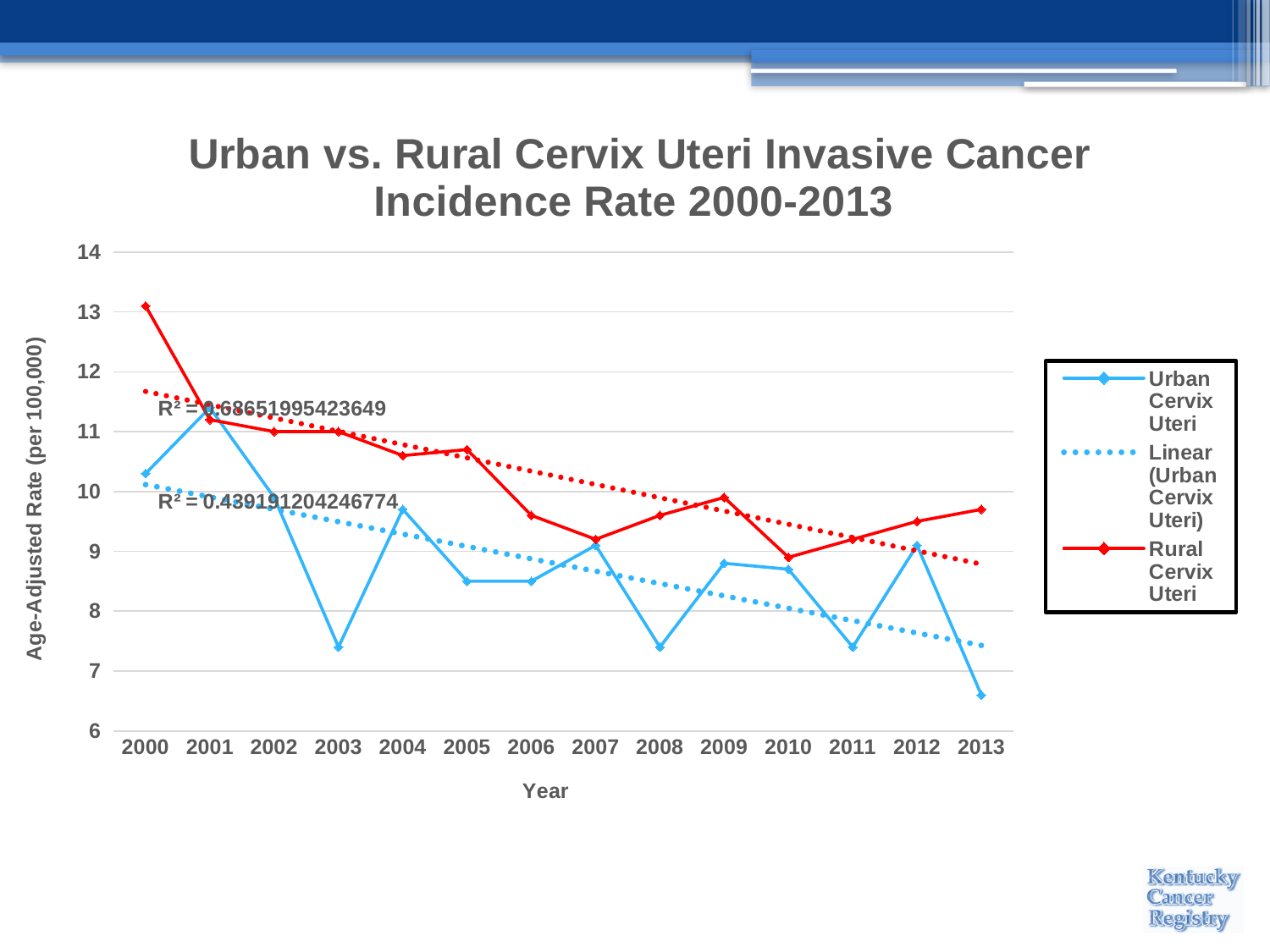
In 2000, which is larger, the Urban Cervix Uteri rate or the Rural Cervix Uteri rate? Rural Cervix Uteri How many years are plotted along the x axis? 14 In which year is the Rural Cervix Uteri rate highest? 2000 In 2013, which is larger, the Urban Cervix Uteri rate or the Rural Cervix Uteri rate? Rural Cervix Uteri How many series does the legend list? 3 Is the Urban Cervix Uteri rate in 2003 greater or less than 8? less What kind of chart is shown on the slide? line chart Is the Urban Cervix Uteri rate in 2013 greater or less than 7? less In which year is the Urban Cervix Uteri rate lowest? 2013 What is the label on the y axis? Age-Adjusted Rate (per 100,000) Is the Rural Cervix Uteri rate in 2000 greater or less than 12? greater Does the Urban Cervix Uteri rate generally rise or fall from 2000 to 2013? fall